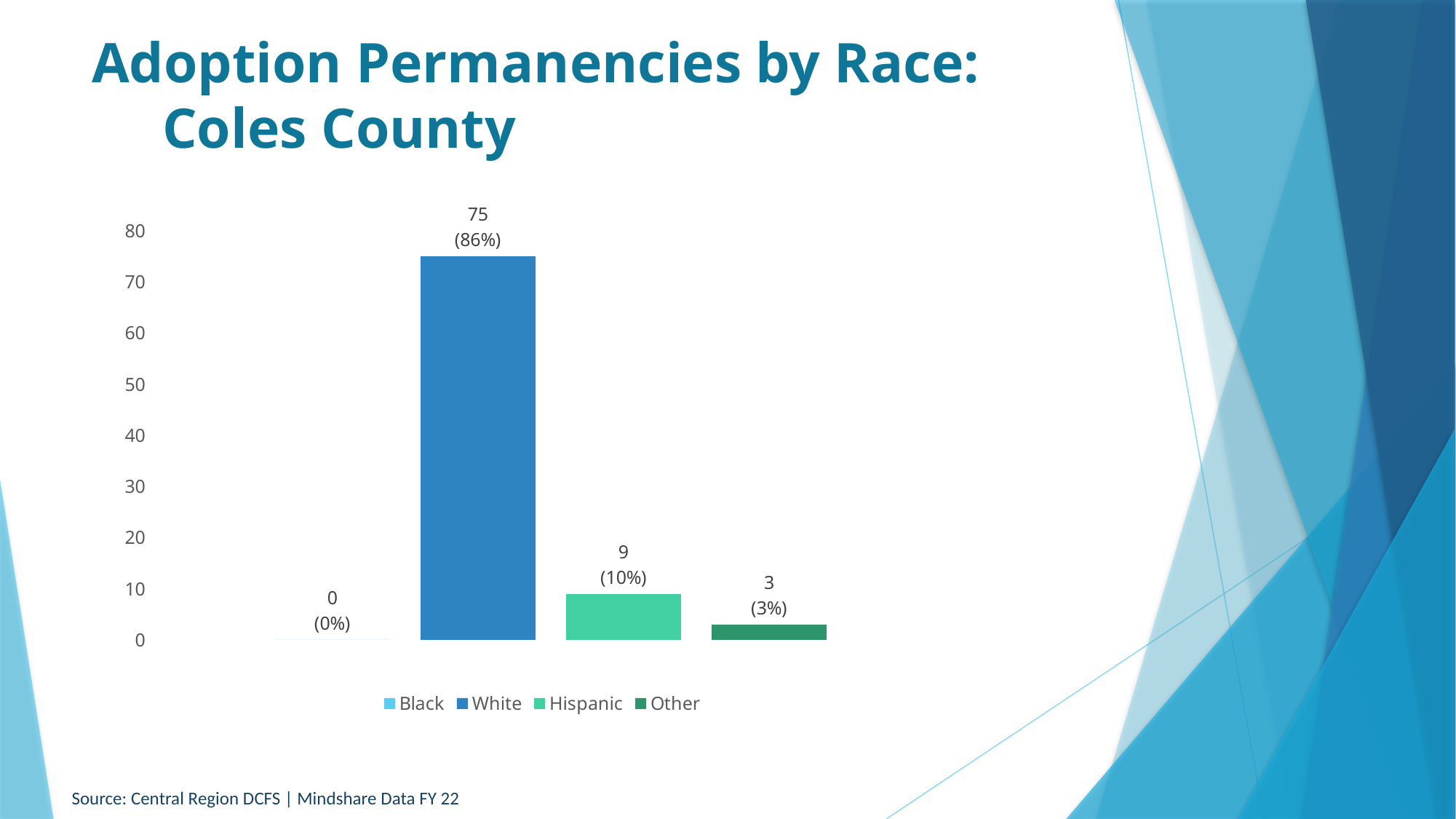
How many race categories does the legend list? 4 Which race category has the lowest number of adoption permanencies? Black What is the number of adoption permanencies for Hispanic? 9 What is the title of the chart on the slide? Adoption Permanencies by Race: Coles County What is the number of adoption permanencies for White? 75 What is the number of adoption permanencies for Other? 3 What percentage of adoption permanencies is shown for Black? 0% What is the difference between the White and Hispanic values? 66 Which is larger, the value for Hispanic or the value for Other? Hispanic Which race category has the highest number of adoption permanencies? White Is the value for White greater or less than 70? greater What kind of chart is shown on the slide? Bar chart